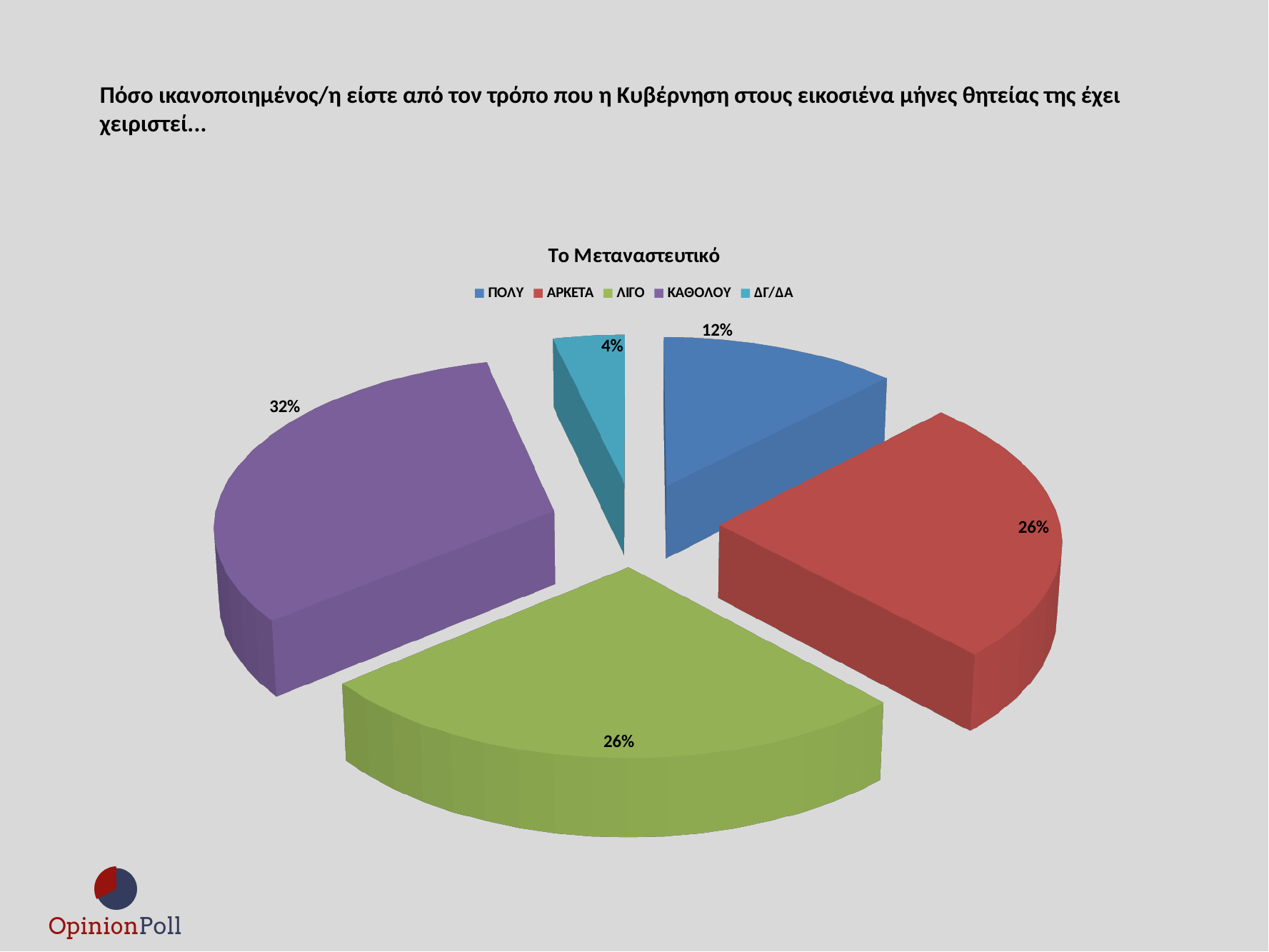
What is the title of the chart? Το Μεταναστευτικό What share of the pie is ΠΟΛΥ? 12% What share of the pie is ΑΡΚΕΤΑ? 26% What share of the pie is ΚΑΘΟΛΟΥ? 32% Which category has the smallest slice? ΔΓ/ΔΑ What colour is the ΚΑΘΟΛΟΥ slice? Purple What type of chart is shown on the slide? Pie chart How many categories does the legend list? 5 What is the difference between the ΚΑΘΟΛΟΥ share and the ΠΟΛΥ share? 20% Which is larger, the ΛΙΓΟ share or the ΠΟΛΥ share? ΛΙΓΟ Which category has the largest slice? ΚΑΘΟΛΟΥ